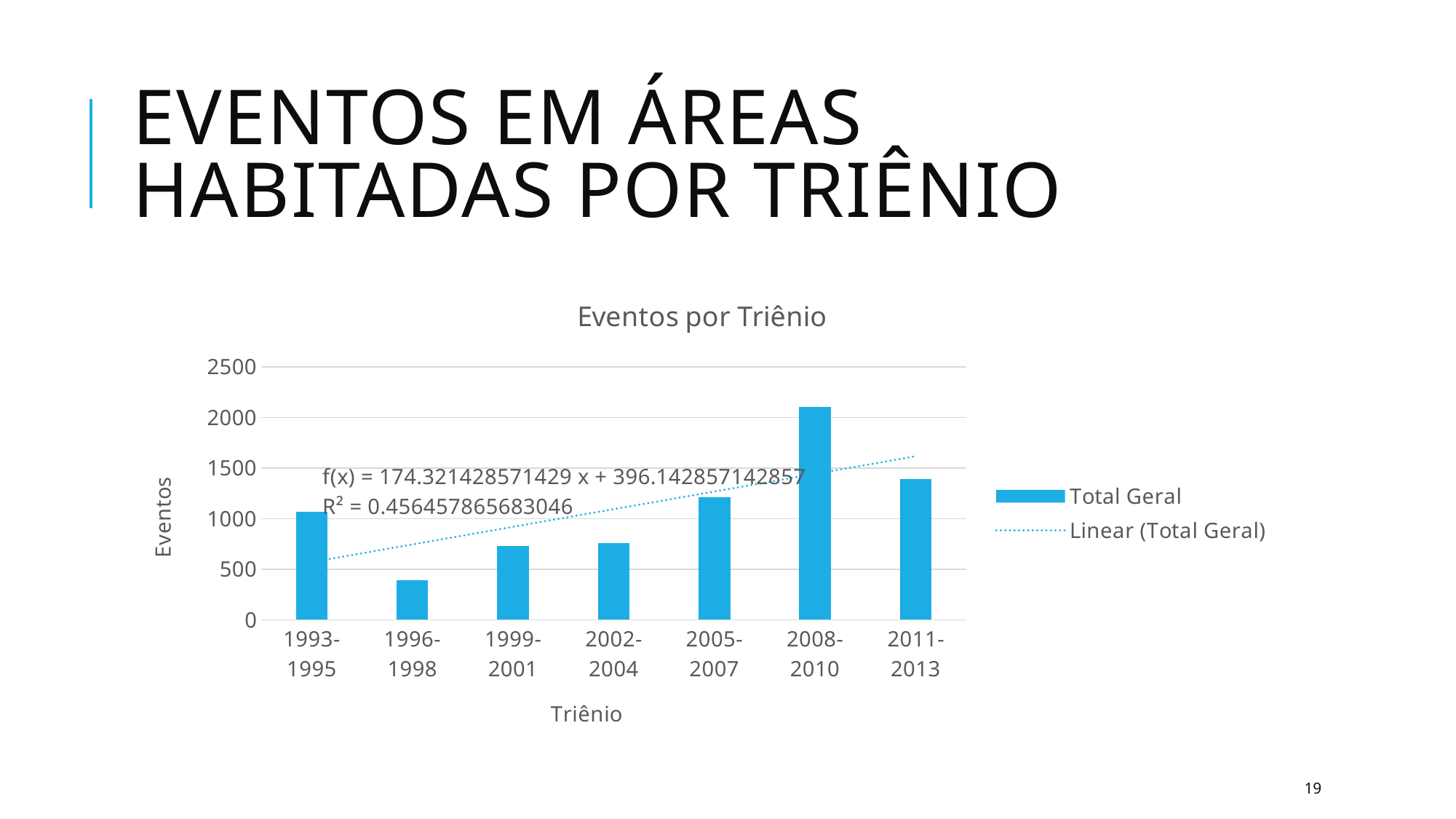
Is the value for 2005-2007 greater or less than 1000? greater Which triênio has the lowest number of eventos? 1996-1998 Does the dotted linear trendline rise or fall from left to right? Rises Is the value for 1996-1998 greater or less than 500? less What is the title of the chart? Eventos por Triênio How many entries does the chart legend list? 2 What kind of chart is shown on the slide? Bar chart Which has more eventos, 2011-2013 or 2005-2007? 2011-2013 Which has more eventos, 1993-1995 or 1996-1998? 1993-1995 Which triênio has the highest number of eventos? 2008-2010 Is the value for 2008-2010 greater or less than 2000? greater How many triênio categories are plotted on the x axis? 7